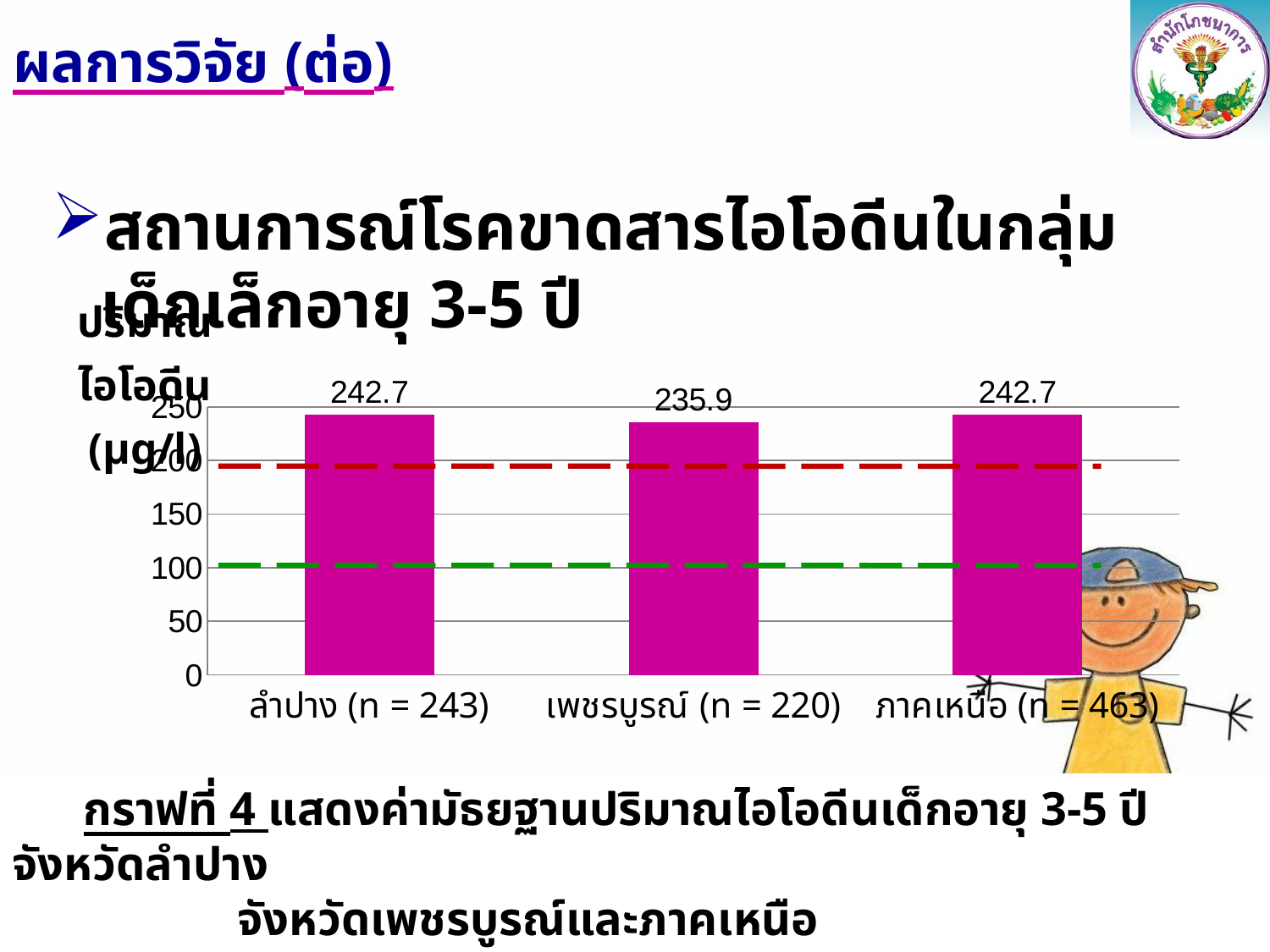
What kind of chart is shown on the slide? bar chart How many categories are shown on the x axis? 3 Which category has the lowest value? เพชรบูรณ์ (n = 220) What is the highest tick value shown on the y axis? 250 Which is larger, the value for ลำปาง (n = 243) or the value for เพชรบูรณ์ (n = 220)? ลำปาง (n = 243) What colour are the bars in the chart? magenta What is the value for เพชรบูรณ์ (n = 220)? 235.9 What is the difference between the values for ลำปาง (n = 243) and เพชรบูรณ์ (n = 220)? 6.8 What is the value for ภาคเหนือ (n = 463)? 242.7 What is the value for ลำปาง (n = 243)? 242.7 Is the value for ภาคเหนือ (n = 463) greater or less than 250? less Is the value for เพชรบูรณ์ (n = 220) greater or less than 200? greater